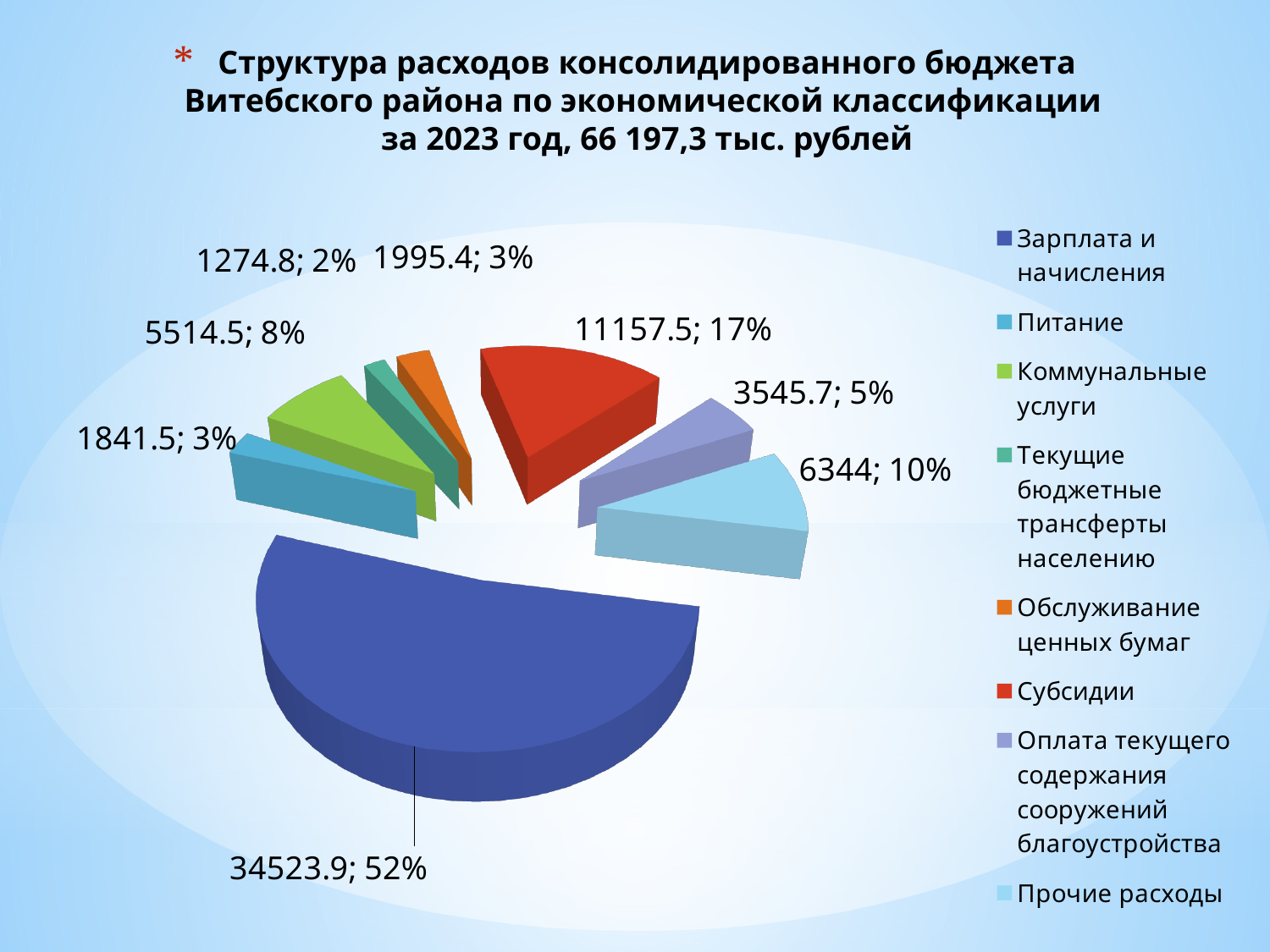
What value is shown for Оплата текущего содержания сооружений благоустройства? 3545.7 How many categories does the legend of the pie chart list? 8 What value is shown for Зарплата и начисления? 34523.9 What total amount is stated in the chart title? 66 197,3 тыс. рублей What share of the pie does Субсидии take? 17% What kind of chart is shown on the slide? pie chart Which category has the smallest slice of the pie? Текущие бюджетные трансферты населению What is the difference between the values for Субсидии and Прочие расходы? 4813.5 What share of the pie does Коммунальные услуги take? 8% What value is shown for Прочие расходы? 6344 Which category has the largest slice of the pie? Зарплата и начисления Which is larger, Субсидии or Прочие расходы? Субсидии